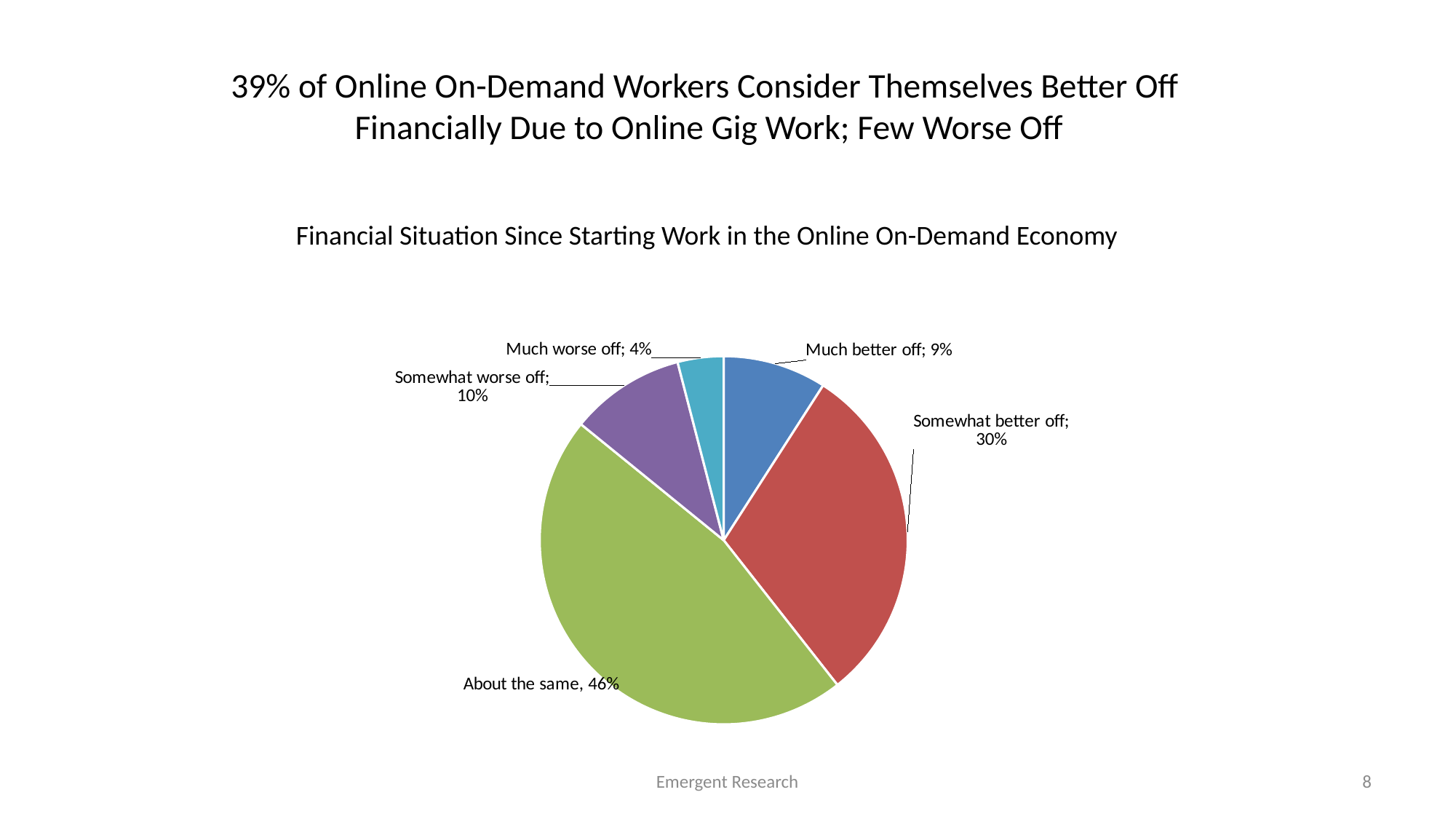
Which category has the largest slice of the pie? About the same What is the title of the chart? Financial Situation Since Starting Work in the Online On-Demand Economy What is the value for 'Much better off'? 9% What is the value for 'Somewhat better off'? 30% How many slices does the pie chart have? 5 Which category has the smallest slice of the pie? Much worse off What kind of chart is shown on the slide? pie chart Which is larger, 'Somewhat worse off' or 'Much better off'? Somewhat worse off What is the value for 'Much worse off'? 4% What is the value for 'Somewhat worse off'? 10% What is the difference between 'About the same' and 'Somewhat better off'? 16% What share of the pie is 'About the same'? 46%